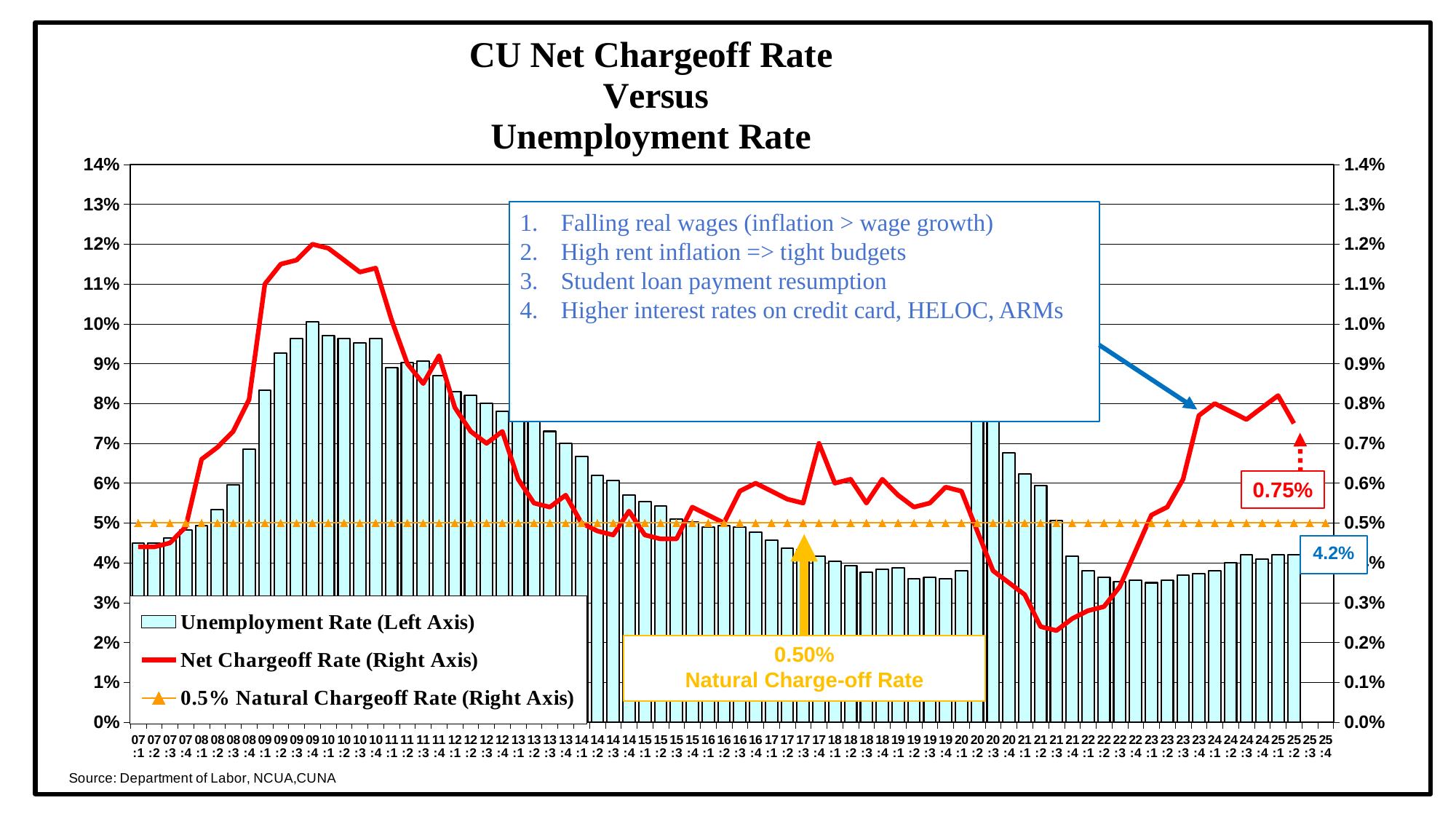
Is the Unemployment Rate at 23:1 greater or less than 4%? less How many series does the legend list? 3 Is the Net Chargeoff Rate at 21:3 greater or less than 0.3%? less Which is larger, the latest labeled Net Chargeoff Rate or the Natural Charge-off Rate? Net Chargeoff Rate What is the title of the chart? CU Net Chargeoff Rate Versus Unemployment Rate Is the Net Chargeoff Rate at 09:4 greater or less than 1.0%? greater What is the most recent Net Chargeoff Rate value labeled on the chart? 0.75% In which quarter does the Net Chargeoff Rate reach its highest point? 09:4 What is the most recent Unemployment Rate value labeled on the chart? 4.2% What kind of chart is this? Combination bar and line chart What value is given for the Natural Charge-off Rate? 0.50% By how much does the latest labeled Net Chargeoff Rate (0.75%) exceed the 0.50% Natural Charge-off Rate? 0.25%